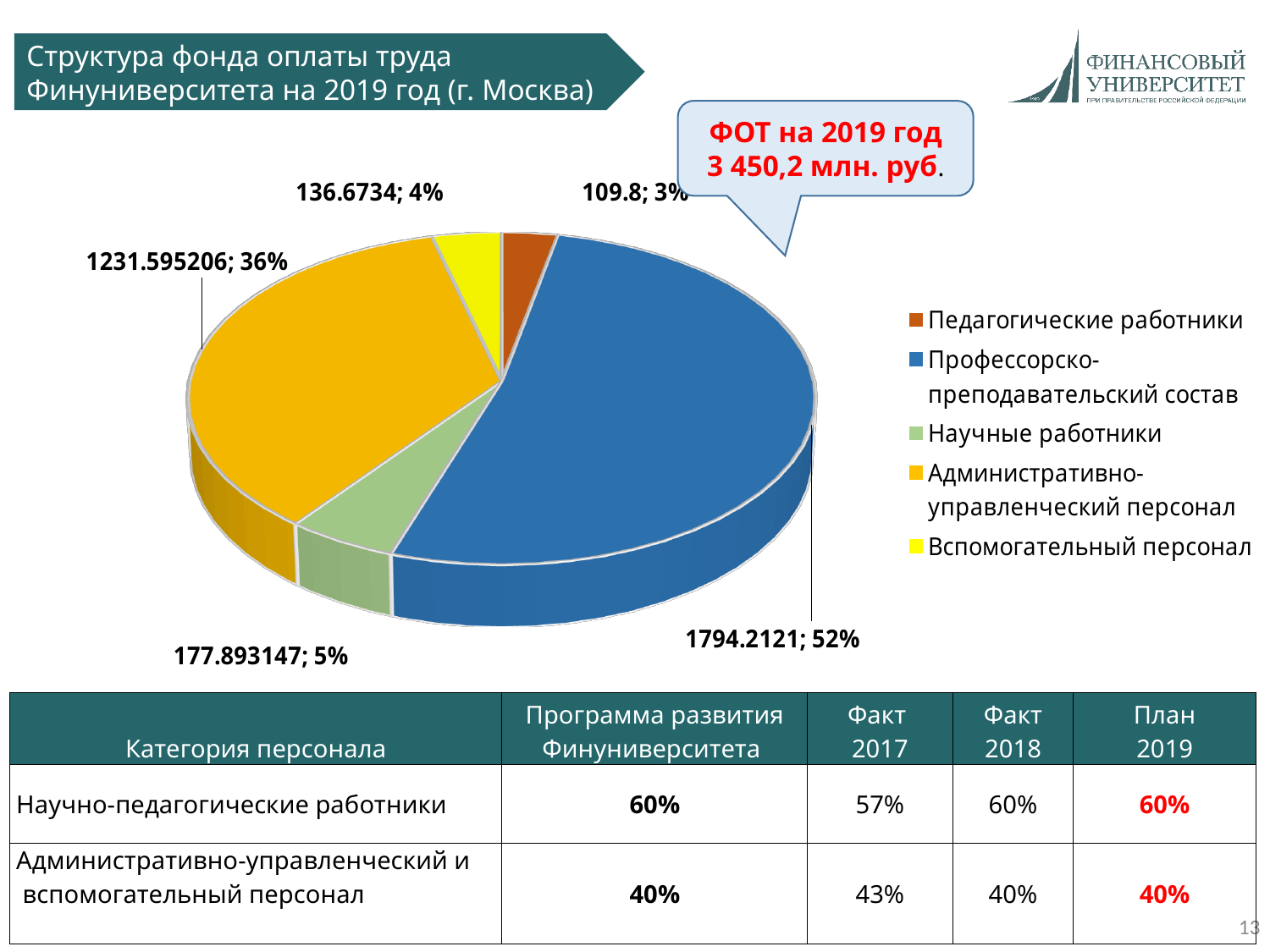
What value is shown for Профессорско-преподавательский состав in the pie chart? 1794.2121 Which category has the largest slice in the pie chart? Профессорско-преподавательский состав What kind of chart is shown on the slide? pie chart What colour is the slice for Административно-управленческий персонал in the pie chart? orange What share of the pie does Педагогические работники have? 3% Which category has the smallest slice in the pie chart? Педагогические работники Which is larger in the pie chart: Научные работники or Вспомогательный персонал? Научные работники How many entries does the legend of the pie chart list? 5 What share of the pie does Административно-управленческий персонал have? 36% What value is shown for Вспомогательный персонал in the pie chart? 136.6734 How many slices does the pie chart have? 5 What value is shown for Научные работники in the pie chart? 177.893147